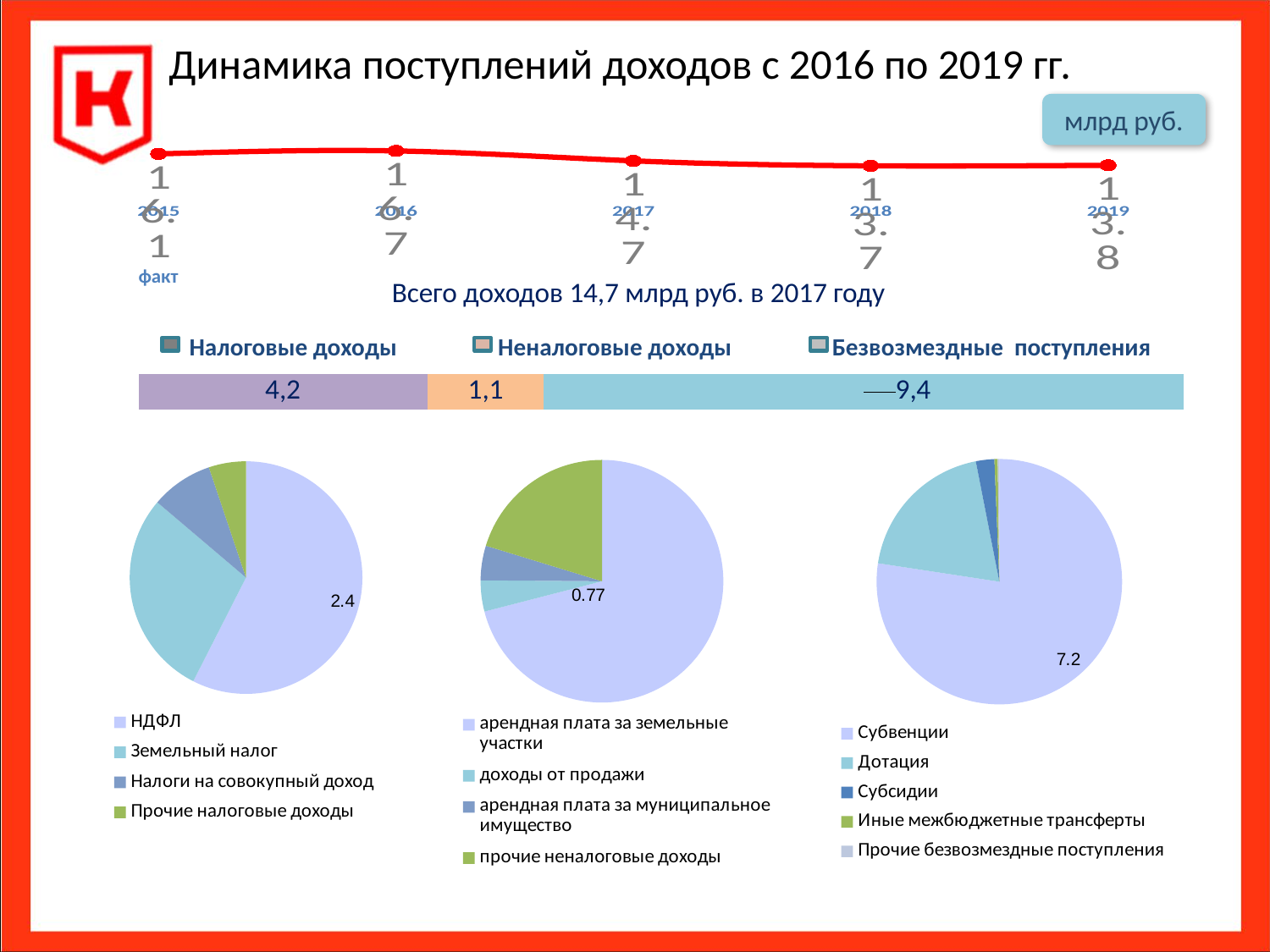
In the stacked bar chart, what is the total of all three segments? 14,7 In the stacked bar chart, what is the value for Налоговые доходы? 4,2 In the stacked bar chart, what is the value for Безвозмездные поступления? 9,4 In the stacked bar chart, which segment has the smallest value? Неналоговые доходы In the left pie chart, what is the value shown for НДФЛ? 2.4 In the right pie chart, what is the value shown for Субвенции? 7.2 What kind of chart is the chart at the top of the slide showing the years 2015 to 2019? line chart In the left pie chart, which category has the largest slice? НДФЛ In the stacked bar chart, what is the difference between Безвозмездные поступления and Налоговые доходы? 5,2 In the middle pie chart, what is the value shown for арендная плата за земельные участки? 0.77 How many categories does the legend of the right pie chart list? 5 How many series does the legend of the stacked bar chart list? 3